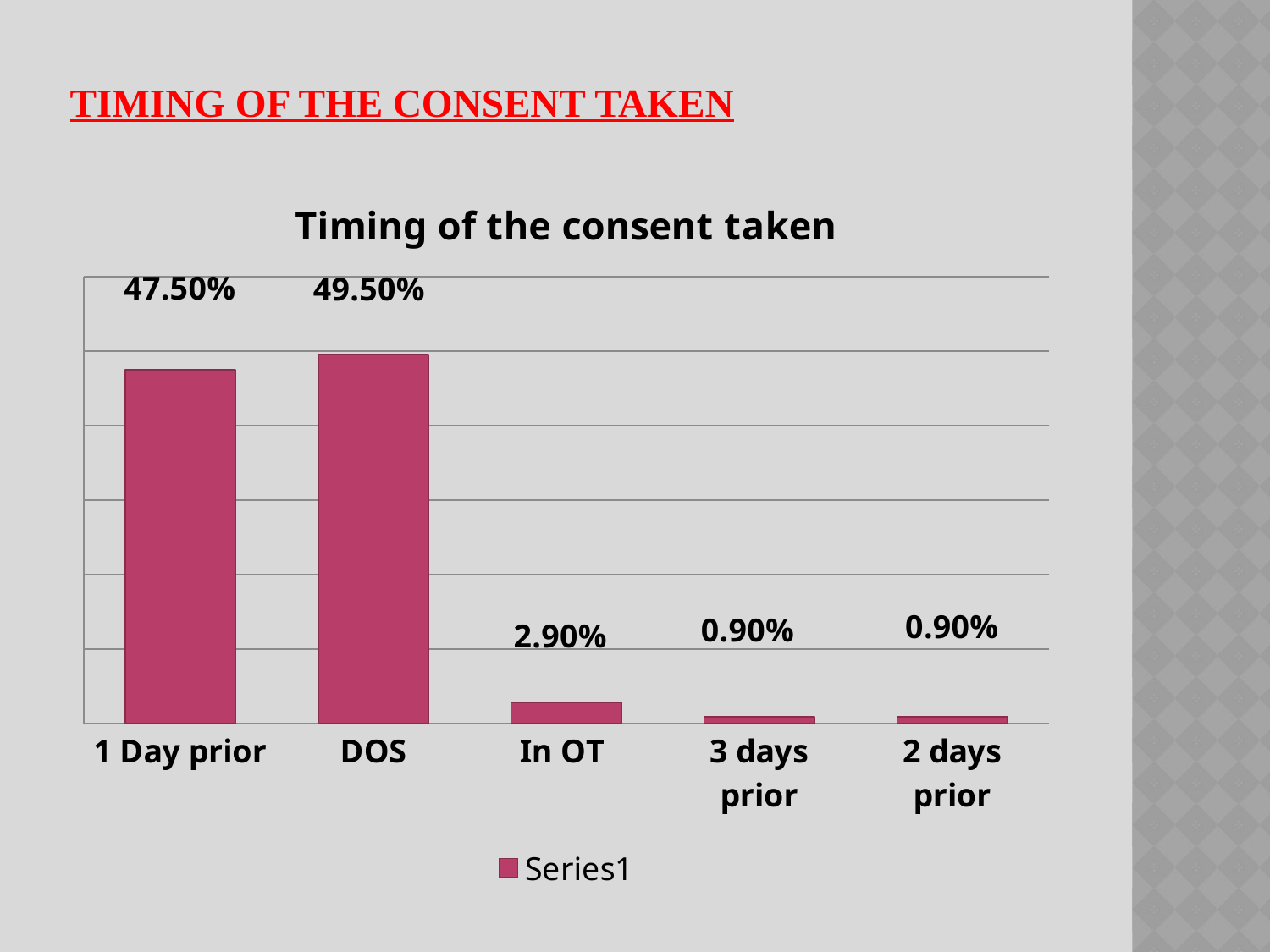
What is the value for In OT? 2.90% What is the value for 3 days prior? 0.90% What is the title of the chart? Timing of the consent taken What is the difference between the values for In OT and 2 days prior? 2.00% Which category has the highest value? DOS Which is larger, the value for 1 Day prior or the value for In OT? 1 Day prior What is the value for DOS? 49.50% What is the difference between the values for DOS and 1 Day prior? 2.00% What is the value for 1 Day prior? 47.50% How many series does the legend list? 1 How many categories are shown on the x axis? 5 What kind of chart is shown? Bar chart